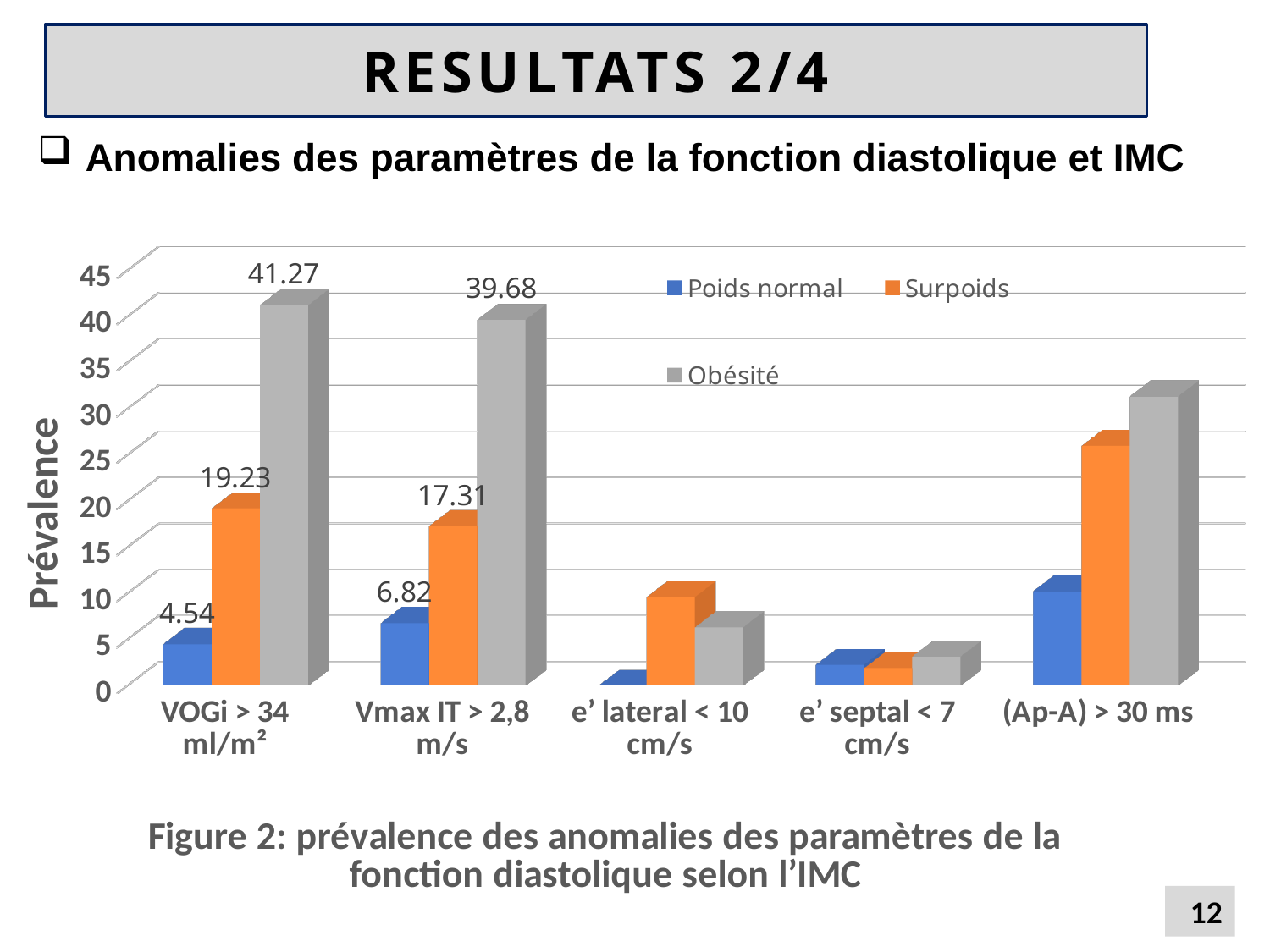
Which series has the lowest value in the Vmax IT > 2,8 m/s category? Poids normal What is the value for Obésité in the VOGi > 34 ml/m² category? 41.27 How many series does the legend list? 3 How many categories are shown on the x axis? 5 What is the value for Obésité in the Vmax IT > 2,8 m/s category? 39.68 What is the value for Poids normal in the VOGi > 34 ml/m² category? 4.54 Which series has the highest value in the VOGi > 34 ml/m² category? Obésité Which is larger: the Surpoids value for VOGi > 34 ml/m² or the Surpoids value for Vmax IT > 2,8 m/s? VOGi > 34 ml/m² Is the value for Surpoids in the (Ap-A) > 30 ms category greater or less than 20? greater What kind of chart is shown on the slide? bar chart What is the value for Surpoids in the Vmax IT > 2,8 m/s category? 17.31 What is the difference between the Obésité and Surpoids values in the VOGi > 34 ml/m² category? 22.04